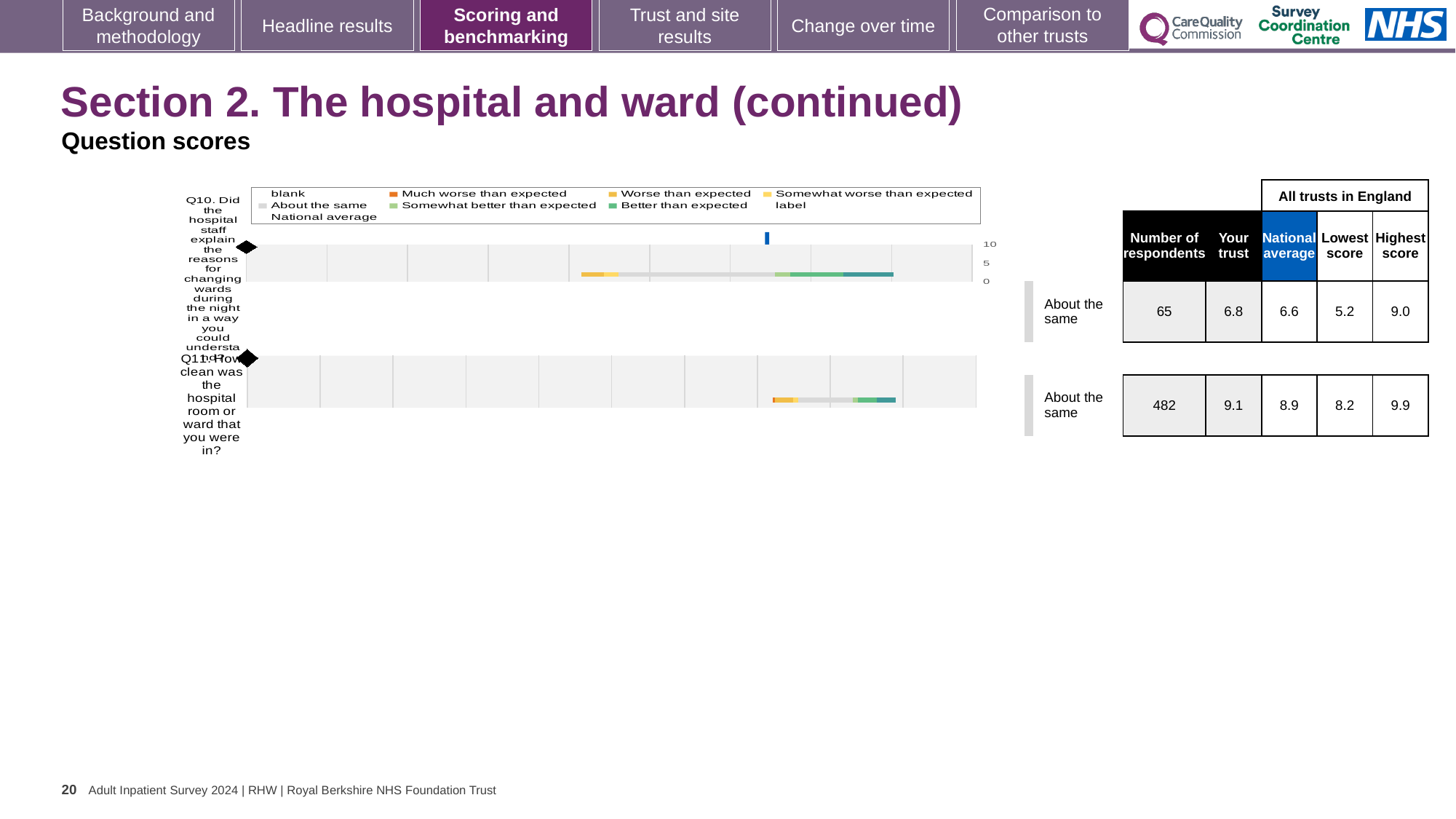
For Q10, how much higher is the 'Your trust' score than the national average? 0.2 For Q11 (how clean was the hospital room or ward), what is the 'Your trust' score? 9.1 For Q10 (explaining reasons for changing wards during the night), what is the 'Your trust' score? 6.8 What kind of chart is used to show the question scores for Q10 and Q11? Bar chart For Q10, what is the lowest score among all trusts in England? 5.2 How many respondents answered Q11? 482 For Q11, what is the difference between the highest score and the lowest score among all trusts in England? 1.7 What benchmark category is shown for Q10? About the same For Q10, what is the national average score? 6.6 For Q11, which is larger: the 'Your trust' score or the national average? Your trust For Q11, what is the national average score? 8.9 How many survey questions are plotted on the slide? 2